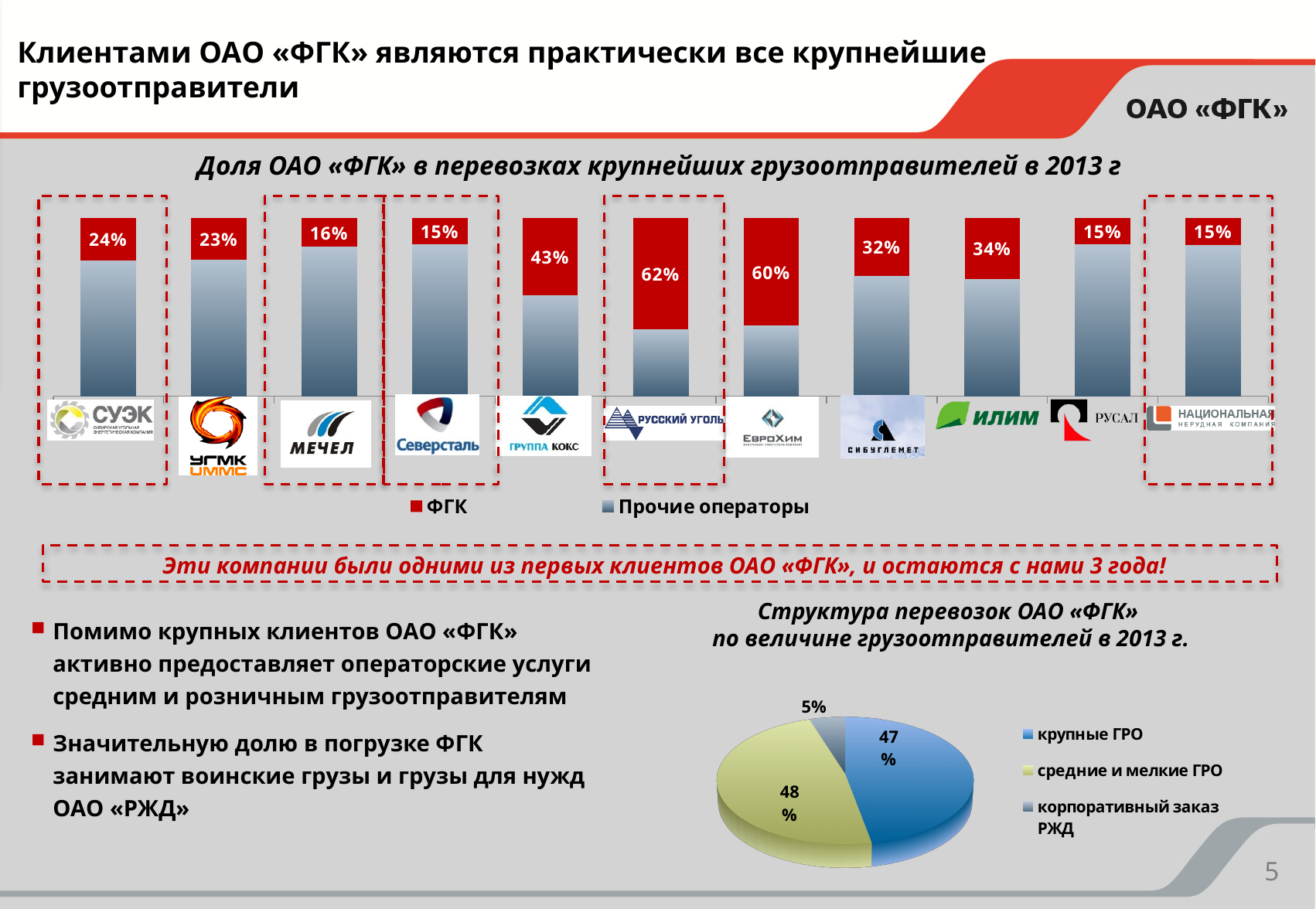
In the chart 'Доля ОАО «ФГК» в перевозках крупнейших грузоотправителей в 2013 г', what is the ФГК share for Русский уголь? 62% In the chart 'Доля ОАО «ФГК» в перевозках крупнейших грузоотправителей в 2013 г', what is the ФГК share for Илим? 34% In the chart 'Доля ОАО «ФГК» в перевозках крупнейших грузоотправителей в 2013 г', what is the difference between the ФГК shares for ЕвроХим and Сибуглемет? 28% In the pie chart 'Структура перевозок ОАО «ФГК» по величине грузоотправителей в 2013 г.', what colour is the 'крупные ГРО' slice? Blue In the chart 'Доля ОАО «ФГК» в перевозках крупнейших грузоотправителей в 2013 г', what is the ФГК share for СУЭК? 24% In the pie chart 'Структура перевозок ОАО «ФГК» по величине грузоотправителей в 2013 г.', what share is 'средние и мелкие ГРО'? 48% How many companies are shown in the chart 'Доля ОАО «ФГК» в перевозках крупнейших грузоотправителей в 2013 г'? 11 In the pie chart 'Структура перевозок ОАО «ФГК» по величине грузоотправителей в 2013 г.', which category has the smallest share? корпоративный заказ РЖД What kind of chart is 'Доля ОАО «ФГК» в перевозках крупнейших грузоотправителей в 2013 г'? Stacked bar chart In the chart 'Доля ОАО «ФГК» в перевозках крупнейших грузоотправителей в 2013 г', which has a larger ФГК share, Группа Кокс or УГМК? Группа Кокс How many series does the legend of the chart 'Доля ОАО «ФГК» в перевозках крупнейших грузоотправителей в 2013 г' list? 2 In the chart 'Доля ОАО «ФГК» в перевозках крупнейших грузоотправителей в 2013 г', which company has the highest ФГК share? Русский уголь